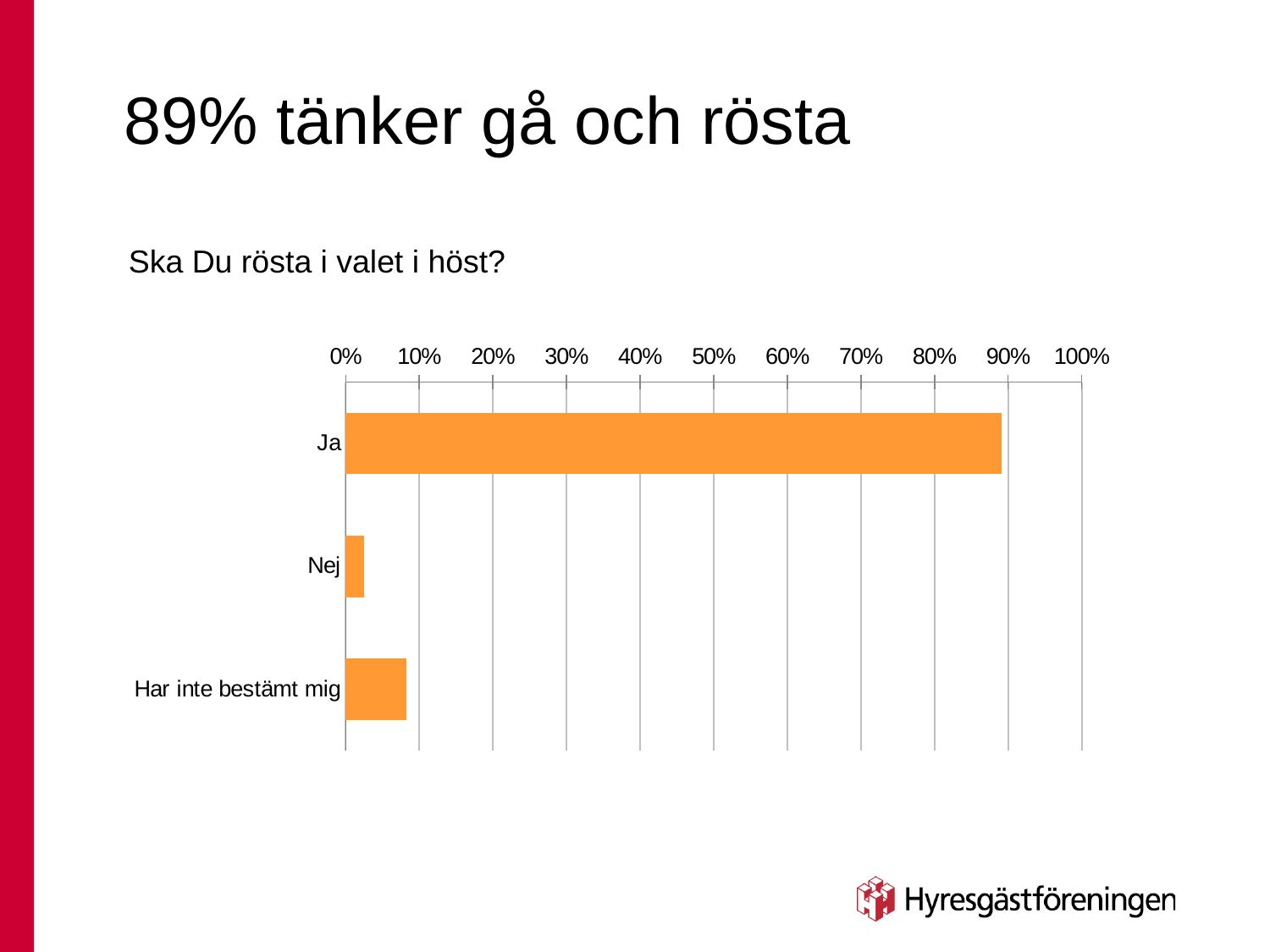
How many categories are shown in the chart? 3 Is the value for Ja greater or less than 50%? greater Which is larger, the value for Nej or the value for Har inte bestämt mig? Har inte bestämt mig What kind of chart is shown on the slide? bar chart What colour are the bars in the chart? orange Is the value for Har inte bestämt mig greater or less than 10%? less Which category has the lowest value in the chart? Nej Is the value for Nej greater or less than 10%? less Which is larger, the value for Ja or the value for Har inte bestämt mig? Ja Which category has the highest value in the chart? Ja What survey question is shown above the chart? Ska Du rösta i valet i höst?